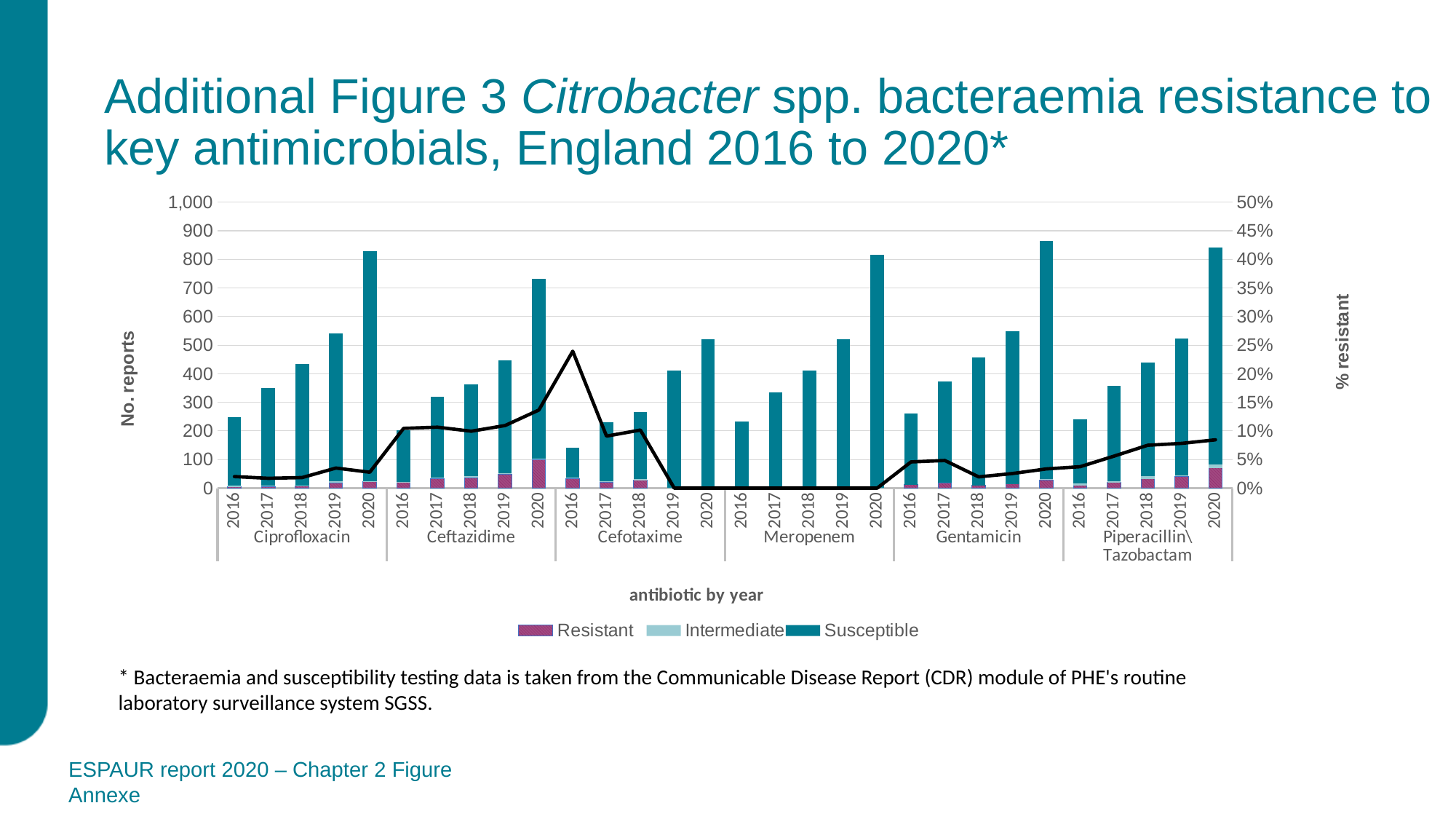
How many antibiotics are shown along the x axis? 6 Is the total number of reports for Meropenem in 2020 greater or less than 700? greater Which is larger, the total number of reports for Ciprofloxacin in 2020 or for Ceftazidime in 2020? Ciprofloxacin 2020 How many years are shown for each antibiotic? 5 What kind of chart is shown on the slide? bar and line chart How many series does the legend list? 3 Which antibiotic and year has the lowest total number of reports? Cefotaxime 2016 Is the total number of reports for Ciprofloxacin in 2020 greater or less than 800? greater Do the total number of reports for Ciprofloxacin rise or fall from 2016 to 2020? rise Is the % resistant for Cefotaxime in 2016 greater or less than 20%? greater What is the label of the right-hand y axis? % resistant